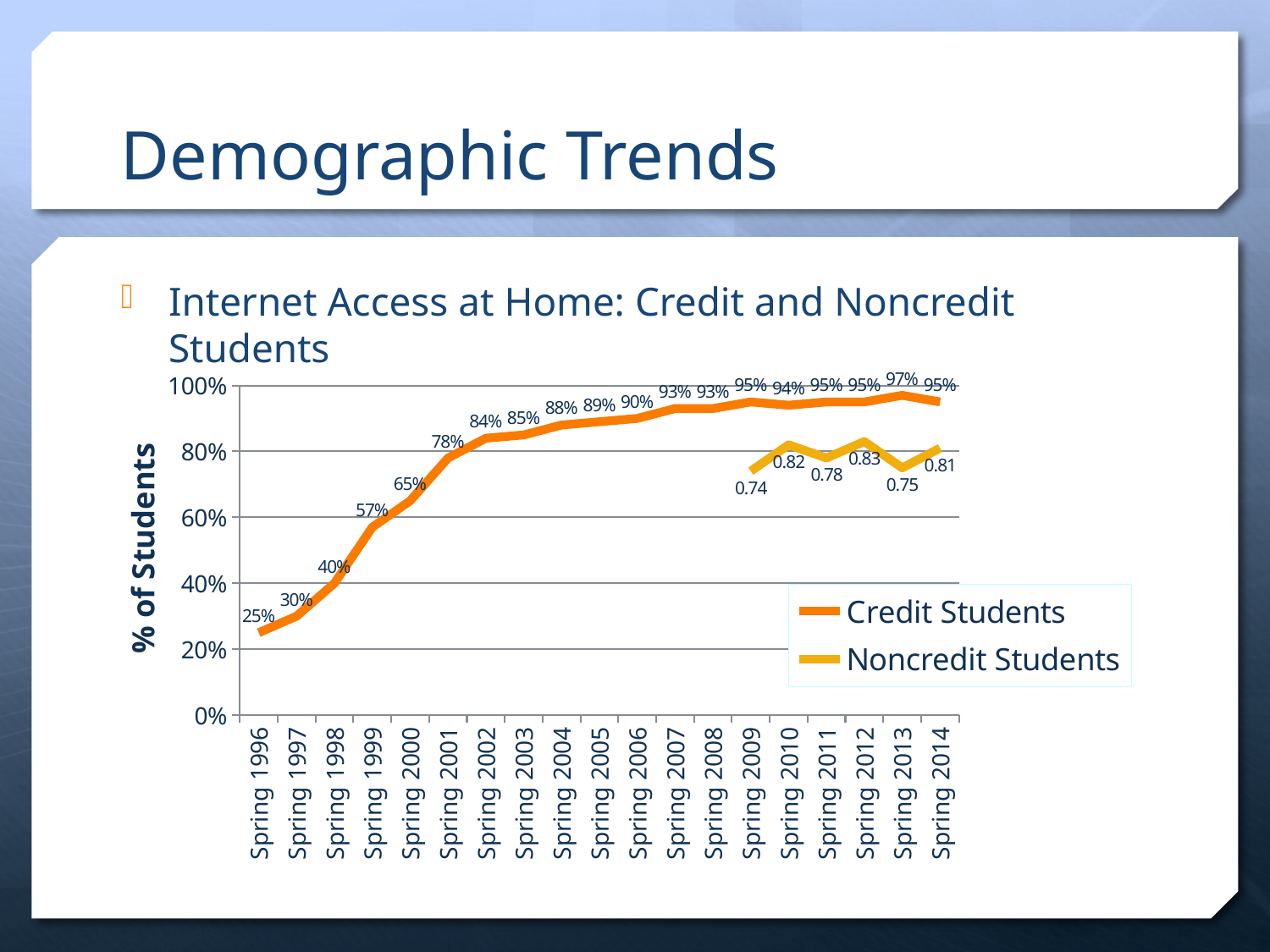
How many Spring terms are shown on the x axis? 19 What kind of chart is shown on the slide? Line chart In which year does the Credit Students series reach its highest value? Spring 2013 What is the value for Credit Students in Spring 2001? 78% In which year is the Noncredit Students value lowest? Spring 2009 What is the value for Credit Students in Spring 1996? 25% Does the Credit Students series generally rise or fall from Spring 1996 to Spring 2014? Rise What is the difference between the Credit Students values in Spring 1999 and Spring 1998? 17% Which is larger, the Noncredit Students value in Spring 2010 or in Spring 2011? Spring 2010 How many series does the legend list? 2 What is the value for Noncredit Students in Spring 2012? 0.83 What is the label on the vertical axis of the chart? % of Students